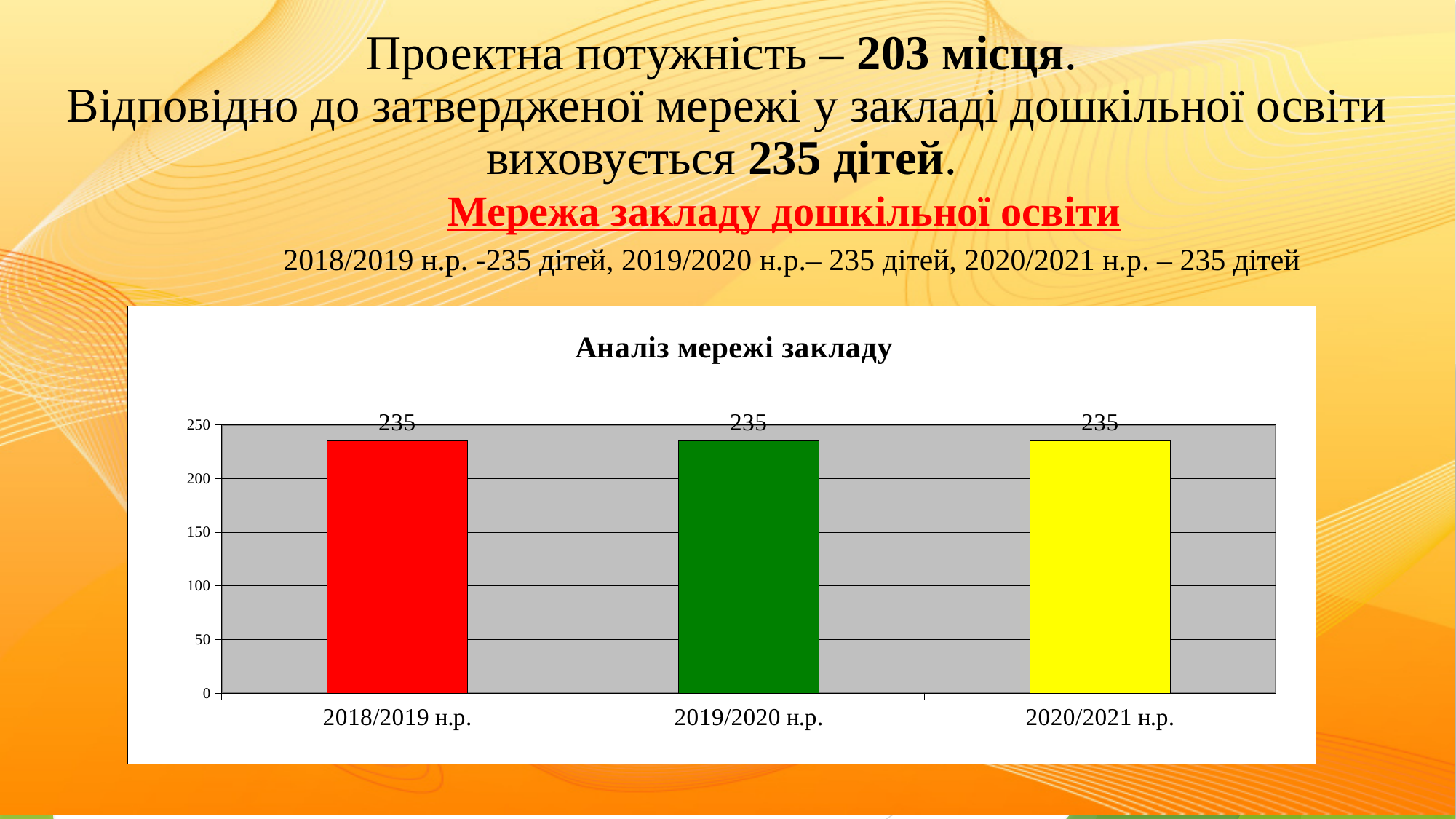
How many categories are shown on the x axis of the chart? 3 Is the value for 2019/2020 н.р. greater or less than 200? greater What kind of chart is shown on the slide? Bar chart What is the difference between the values for 2018/2019 н.р. and 2020/2021 н.р.? 0 Do the values rise, fall or stay the same from 2018/2019 н.р. to 2020/2021 н.р.? Stay the same Is the value for 2020/2021 н.р. greater or less than 250? less What is the title of the chart? Аналіз мережі закладу What colour is the bar for 2019/2020 н.р.? Green What is the value for 2020/2021 н.р. in the chart? 235 What is the value for 2018/2019 н.р. in the chart? 235 What is the value for 2019/2020 н.р. in the chart? 235